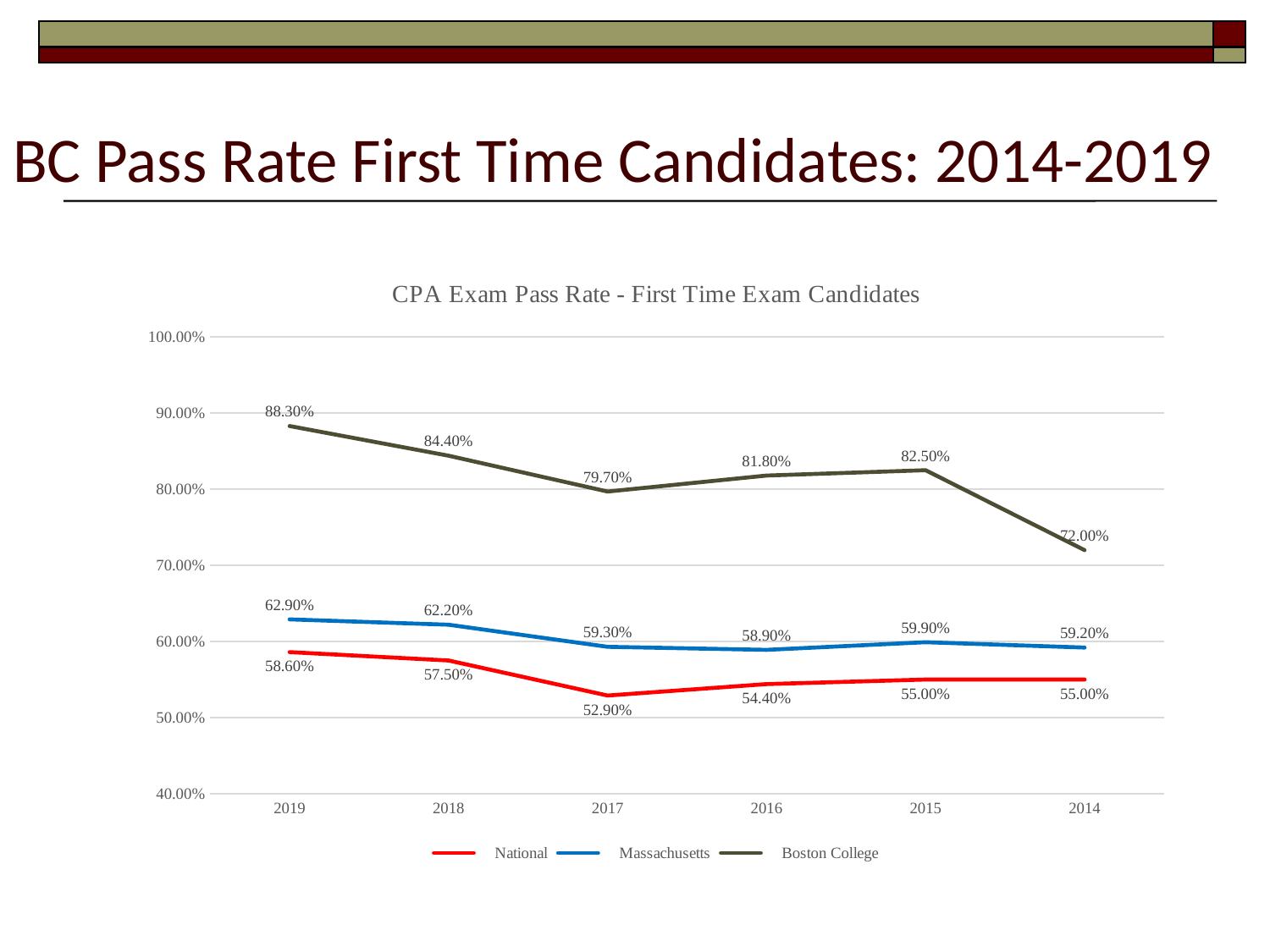
What is the title of the chart? CPA Exam Pass Rate - First Time Exam Candidates What is the difference between the Boston College and National pass rates in 2019? 29.70% Is the Boston College pass rate for 2014 greater or less than 80.00%? less What is the Massachusetts pass rate for 2015? 59.90% What is the National pass rate for 2017? 52.90% In which year is the Massachusetts pass rate highest? 2019 What kind of chart is shown on the slide? line chart How many series does the legend list? 3 What is the Boston College pass rate for 2019? 88.30% How many years are shown on the x axis? 6 Which is higher in 2016, the Massachusetts pass rate or the National pass rate? Massachusetts In which year is the Boston College pass rate lowest? 2014